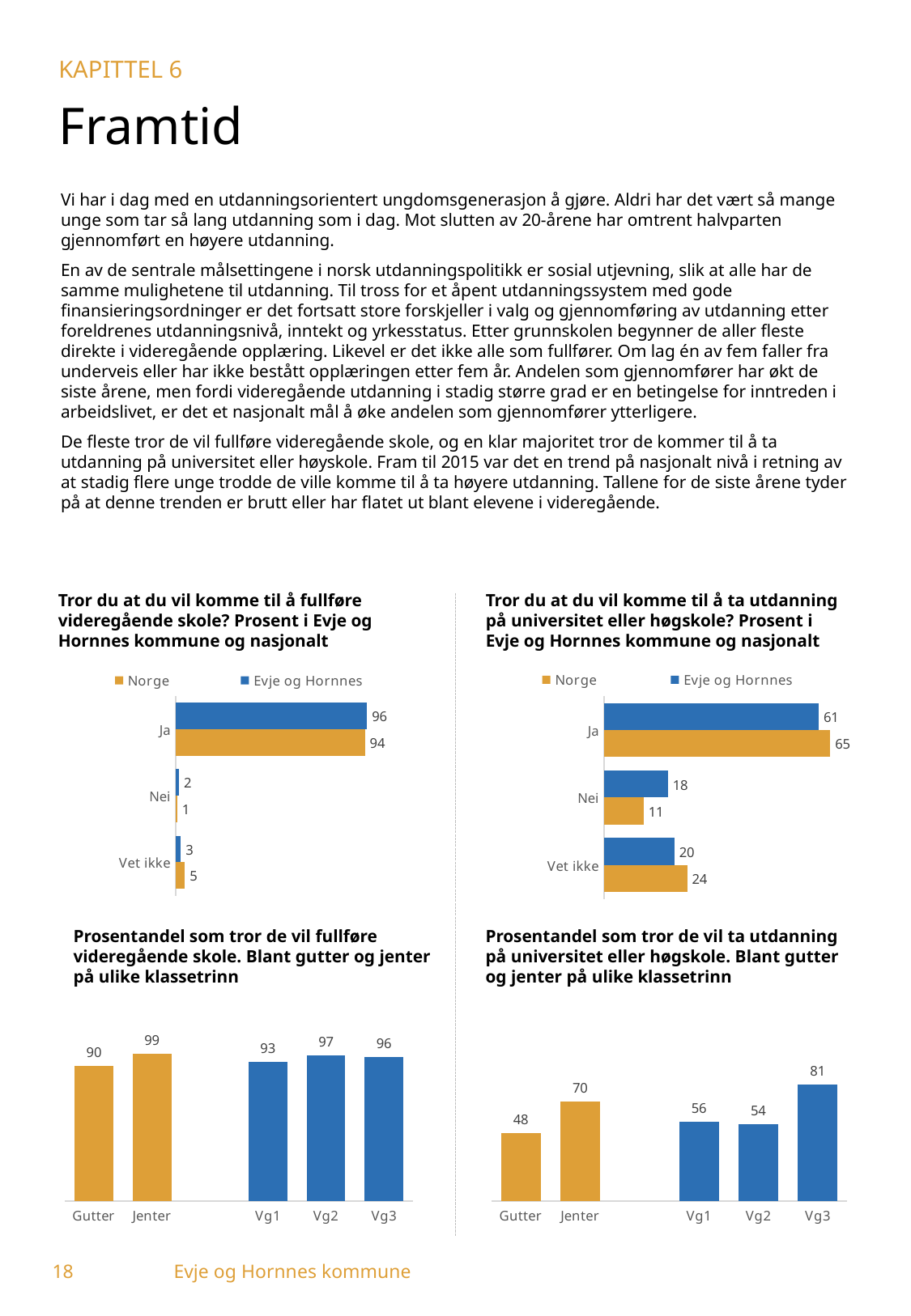
In the top-left chart (Tror du at du vil komme til å fullføre videregående skole?), what is the difference between the Evje og Hornnes and Norge values for 'Ja'? 2 How many categories are shown in the bottom-right chart (Prosentandel som tror de vil ta utdanning på universitet eller høgskole)? 5 How many series does the legend list in the top-right chart (Tror du at du vil komme til å ta utdanning på universitet eller høgskole?)? 2 In the bottom-right chart (Prosentandel som tror de vil ta utdanning på universitet eller høgskole), which category has the lowest value? Gutter In the top-right chart (Tror du at du vil komme til å ta utdanning på universitet eller høgskole?), what is the value for Norge for 'Ja'? 65 In the bottom-left chart (Prosentandel som tror de vil fullføre videregående skole), which category has the highest value? Jenter In the bottom-left chart (Prosentandel som tror de vil fullføre videregående skole), what is the value for Vg2? 97 In the bottom-right chart (Prosentandel som tror de vil ta utdanning på universitet eller høgskole), what is the difference between Jenter and Gutter? 22 In the top-right chart (Tror du at du vil komme til å ta utdanning på universitet eller høgskole?), what is the difference between the Norge and Evje og Hornnes values for 'Vet ikke'? 4 In the top-left chart (Tror du at du vil komme til å fullføre videregående skole?), what is the value for Norge for 'Vet ikke'? 5 In the top-right chart (Tror du at du vil komme til å ta utdanning på universitet eller høgskole?), which is larger for 'Nei': Norge or Evje og Hornnes? Evje og Hornnes In the top-left chart (Tror du at du vil komme til å fullføre videregående skole?), what is the value for Evje og Hornnes for 'Ja'? 96